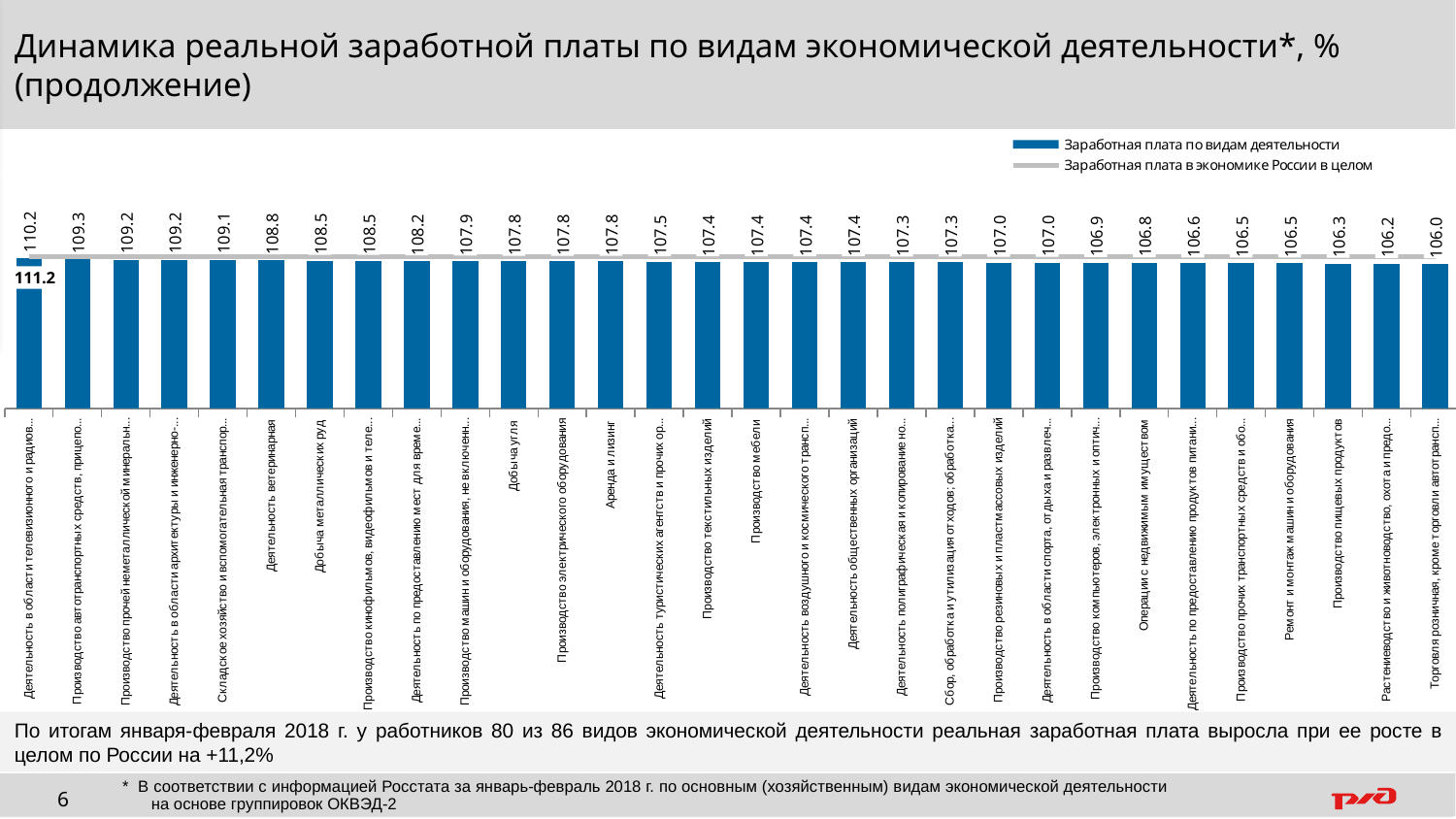
What is the value for 'Добыча угля'? 107.8 What is the difference between the values for 'Добыча металлических руд' and 'Производство мебели'? 1.1 Do the bar values rise or fall from left to right along the x axis? fall What value is shown for the line 'Заработная плата в экономике России в целом'? 111.2 What is the lowest value among the bars on the chart? 106.0 What is the value for 'Операции с недвижимым имуществом'? 106.8 What is the highest value among the bars on the chart? 110.2 What is the value for 'Производство пищевых продуктов'? 106.3 How many series does the legend list? 2 What type of chart is shown on the slide? combination bar and line chart What is the value for 'Деятельность ветеринарная'? 108.8 How many bars (types of economic activity) are plotted on the chart? 30